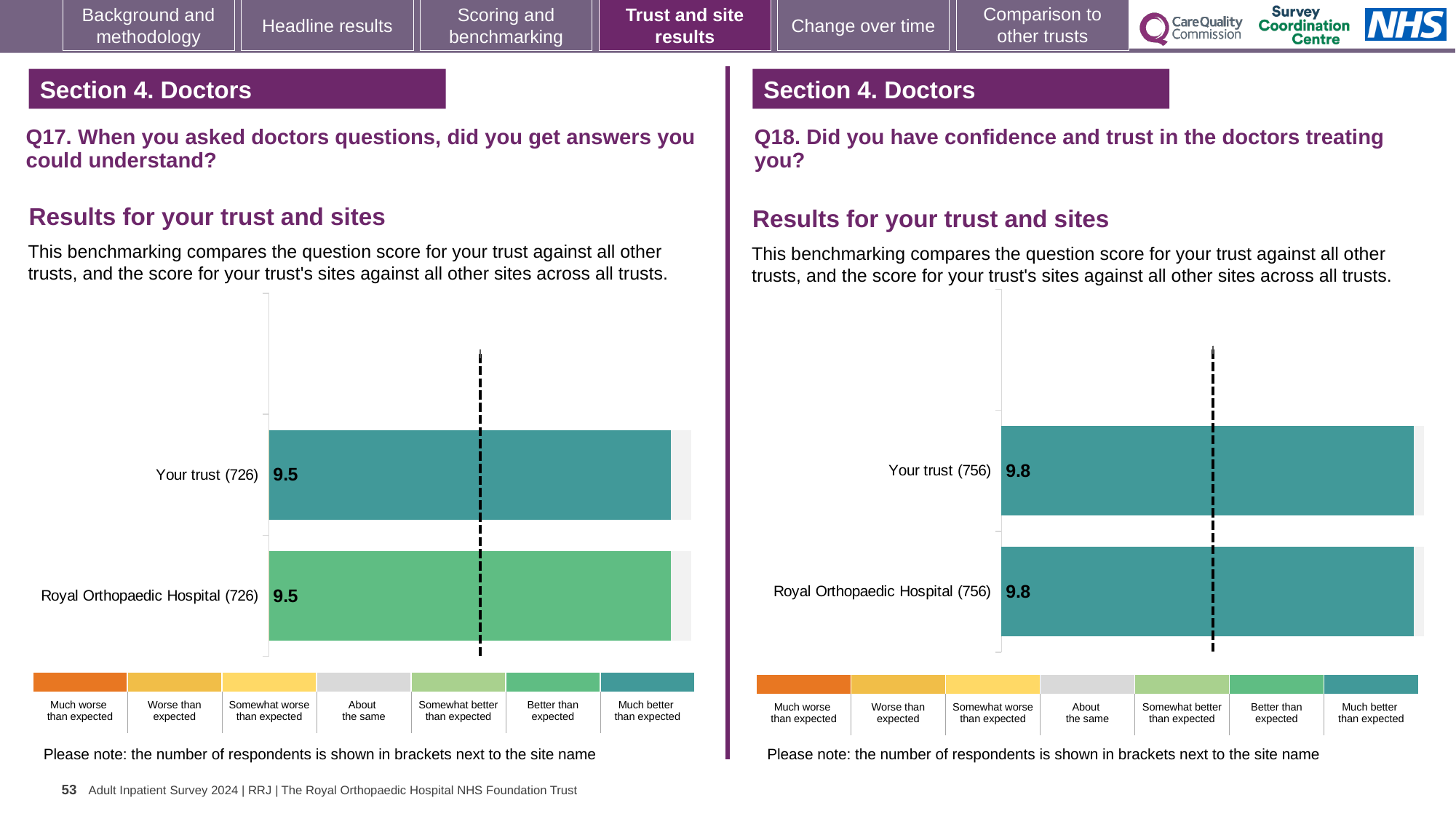
On the Q18 chart (right), what is the score for Your trust (756)? 9.8 On the Q17 chart (left), what is the score for Your trust (726)? 9.5 On the Q17 chart (left), which benchmark category does the colour of the Royal Orthopaedic Hospital (726) bar correspond to in the legend? Better than expected How many respondents are shown in brackets for Your trust on the Q18 chart (right)? 756 On the Q18 chart (right), what is the difference between the score for Your trust (756) and the score for Royal Orthopaedic Hospital (756)? 0.0 What kind of chart is used for the Q17 results on the left? Bar chart On the Q17 chart (left), what is the score for Royal Orthopaedic Hospital (726)? 9.5 On the Q18 chart (right), what is the score for Royal Orthopaedic Hospital (756)? 9.8 How many bars are plotted on the Q18 chart (right)? 2 On the Q18 chart (right), which benchmark category does the colour of the Your trust (756) bar correspond to in the legend? Much better than expected On the Q17 chart (left), what is the difference between the score for Your trust (726) and the score for Royal Orthopaedic Hospital (726)? 0.0 How many bars are plotted on the Q17 chart (left)? 2